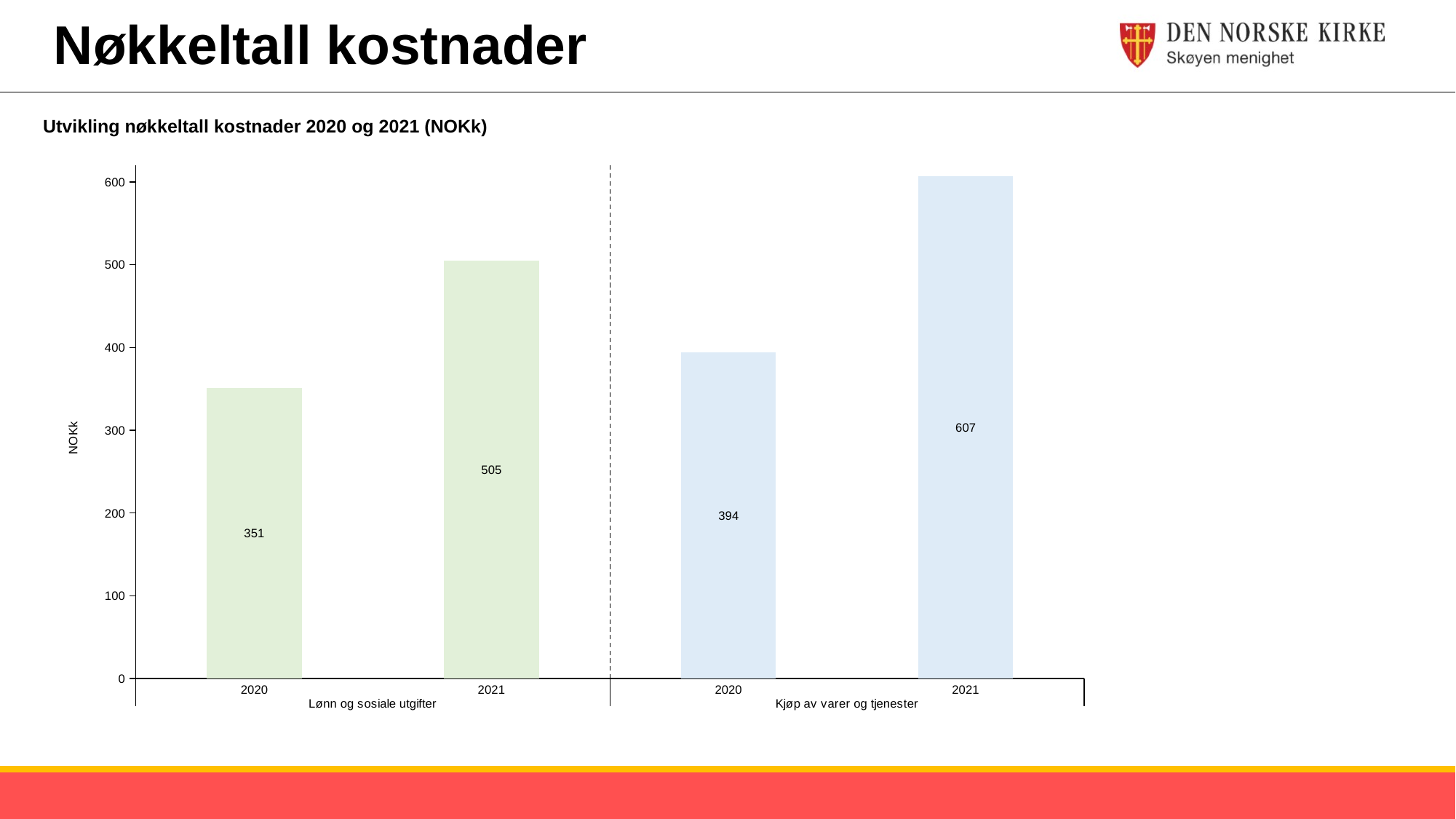
By how much did Kjøp av varer og tjenester increase from 2020 to 2021? 213 Which bar has the highest value on the chart? Kjøp av varer og tjenester 2021 Which bar has the lowest value on the chart? Lønn og sosiale utgifter 2020 By how much did Lønn og sosiale utgifter increase from 2020 to 2021? 154 Which is larger: Lønn og sosiale utgifter in 2021 or Kjøp av varer og tjenester in 2020? Lønn og sosiale utgifter in 2021 What is the value for Kjøp av varer og tjenester in 2020? 394 What is the value for Lønn og sosiale utgifter in 2020? 351 What is the value for Lønn og sosiale utgifter in 2021? 505 What kind of chart is shown on the slide? Bar chart What is the label on the vertical axis of the chart? NOKk What is the value for Kjøp av varer og tjenester in 2021? 607 How many bars are plotted on the chart? 4